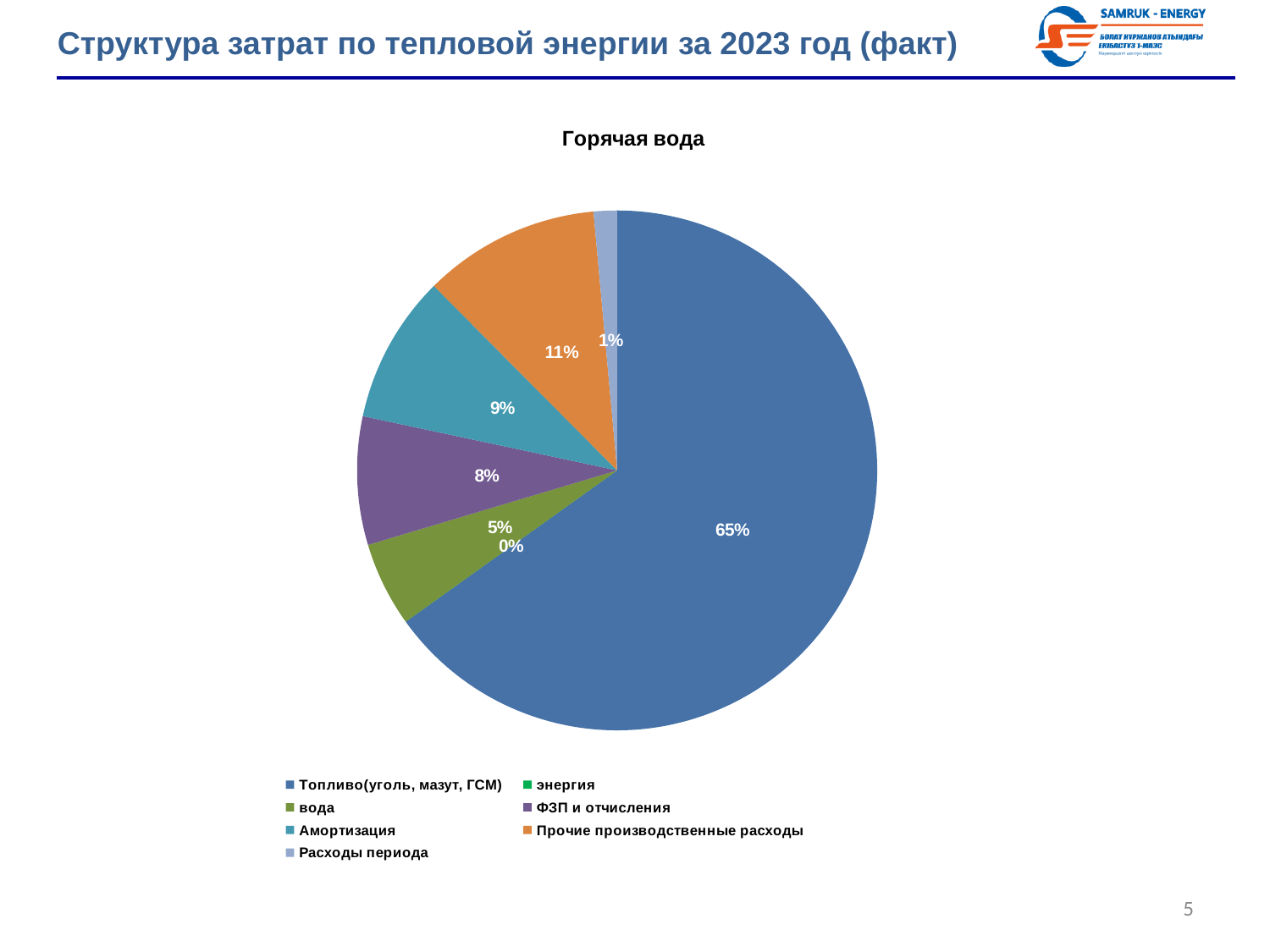
What share of the pie does ФЗП и отчисления take? 8% What share of the pie does Топливо(уголь, мазут, ГСМ) take? 65% Which is larger, the share for Амортизация or the share for вода? Амортизация Which category has the largest share of the pie? Топливо(уголь, мазут, ГСМ) What share of the pie does вода take? 5% What is the title of the chart? Горячая вода What is the difference in percentage points between the share for Топливо(уголь, мазут, ГСМ) and the share for Прочие производственные расходы? 54 What kind of chart is shown on the slide? pie chart How many categories does the legend list? 7